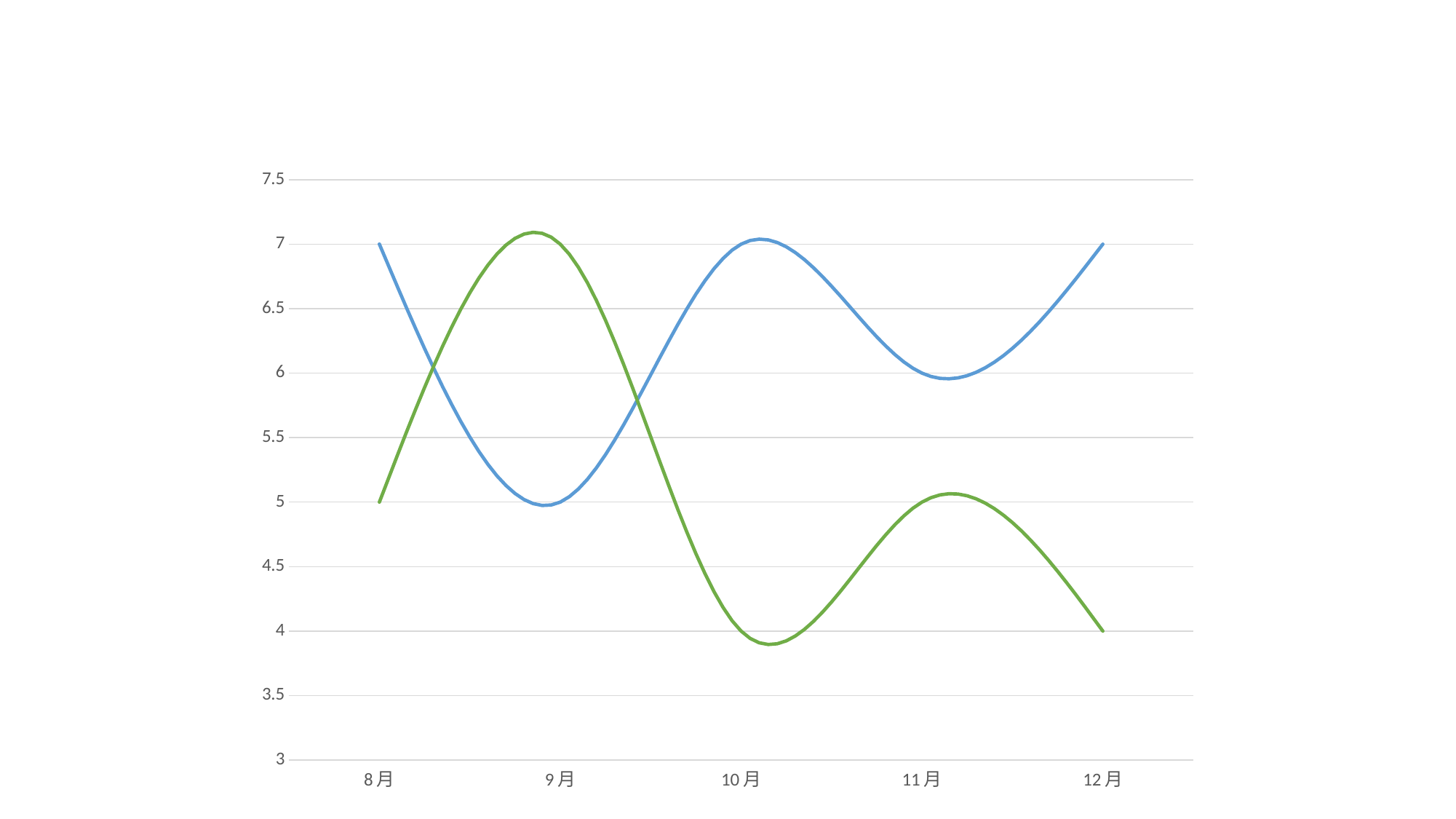
What is the value of the blue line at 12月? 7 At 10月, which line has the higher value, the blue line or the green line? the blue line Is the value of the blue line at 9月 greater or less than 5.5? less How many lines are plotted on the chart? 2 What is the value of the green line at 8月? 5 How many months are shown on the x axis? 5 What is the value of the blue line at 8月? 7 What is the value of the green line at 12月? 4 Is the value of the blue line at 11月 greater or less than 6.5? less What kind of chart is shown on the slide? line chart Is the value of the green line at 10月 greater or less than 4.5? less Does the green line rise or fall from 8月 to 9月? rise